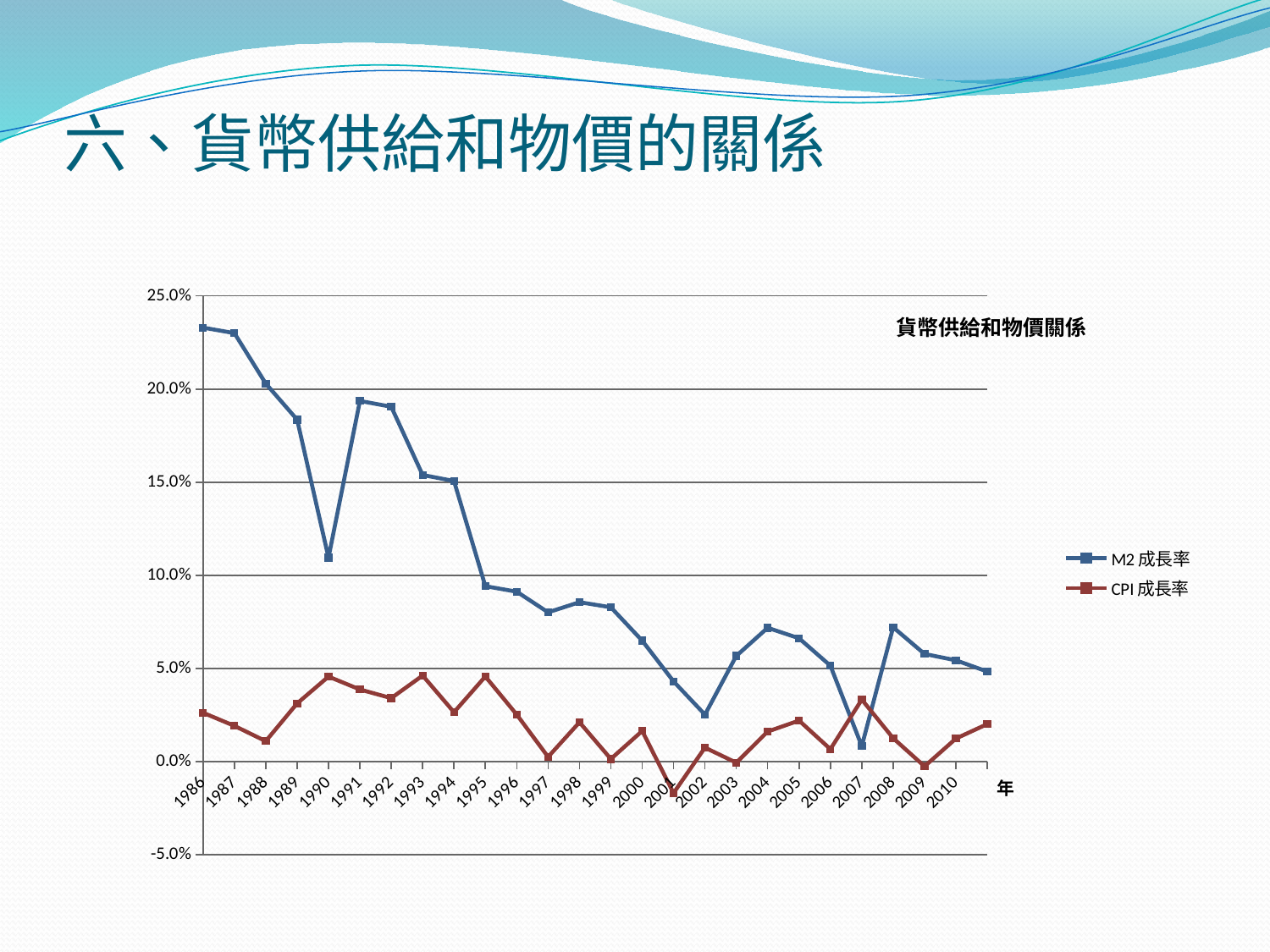
Is the CPI 成長率 value for 2001 greater or less than 0.0%? less What is the title printed inside the chart area? 貨幣供給和物價關係 In 2007, which series has the larger value, M2 成長率 or CPI 成長率? CPI 成長率 Is the M2 成長率 value for 1986 greater or less than 20.0%? greater How many series does the chart legend list? 2 Is the M2 成長率 value for 1990 greater or less than 10.0%? greater What kind of chart is shown on the slide? line chart In which year is the M2 成長率 series at its lowest? 2007 What label is shown on the x axis of the chart? 年 In which year is the CPI 成長率 series at its lowest? 2001 Overall, does the M2 成長率 series rise or fall from 1986 to 2010? fall